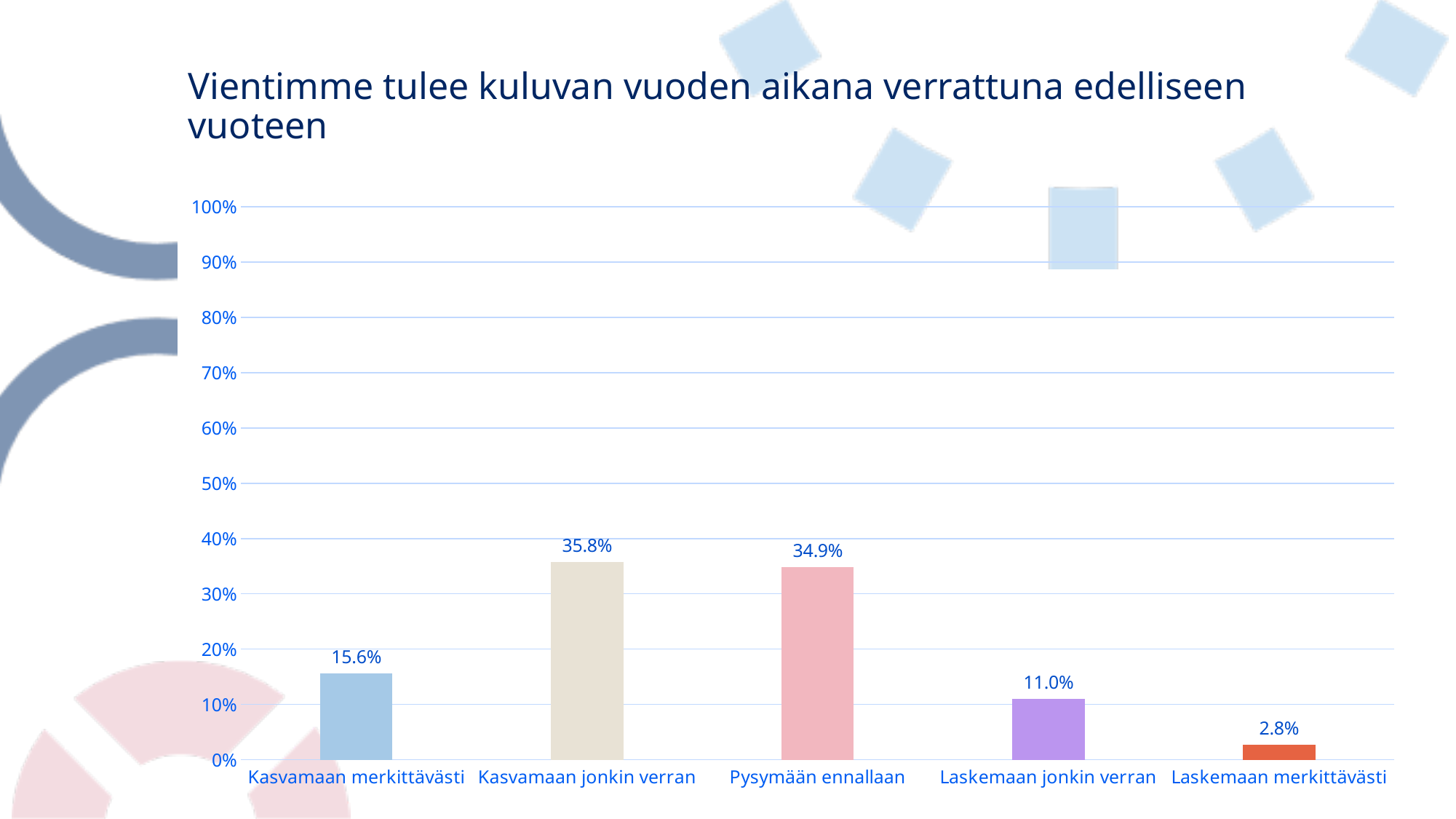
What is the value for "Kasvamaan jonkin verran"? 35.8% What is the value for "Kasvamaan merkittävästi"? 15.6% How many categories are shown on the x axis? 5 Which is larger, the value for "Kasvamaan merkittävästi" or the value for "Laskemaan jonkin verran"? Kasvamaan merkittävästi What kind of chart is shown on the slide? Bar chart What is the value for "Pysymään ennallaan"? 34.9% What is the title of the chart? Vientimme tulee kuluvan vuoden aikana verrattuna edelliseen vuoteen What is the value for "Laskemaan merkittävästi"? 2.8% What is the value for "Laskemaan jonkin verran"? 11.0% Which category has the lowest value? Laskemaan merkittävästi What is the difference between the values for "Kasvamaan jonkin verran" and "Pysymään ennallaan"? 0.9% Which category has the highest value? Kasvamaan jonkin verran